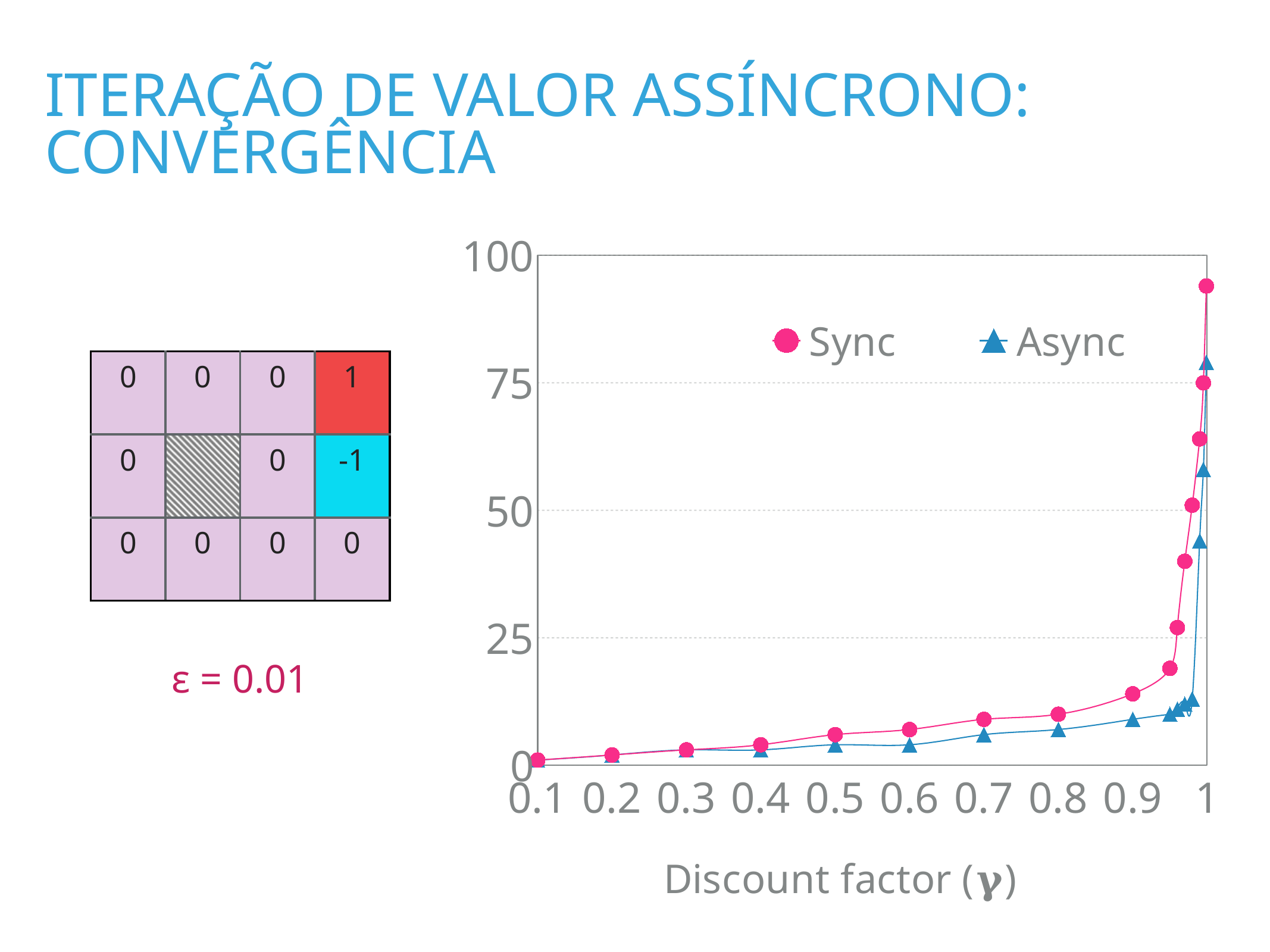
What are the two series named in the chart's legend? Sync and Async Is the Sync value at a discount factor of 0.5 greater or less than 25? less Do the Sync values rise or fall as the discount factor increases from 0.1 to 1? rise How many series does the chart's legend list? 2 What is the label of the chart's x axis? Discount factor (γ) What kind of chart is shown on the slide? line chart At a discount factor of 0.9, which series has the higher value, Sync or Async? Sync Is the Sync value at a discount factor of 0.9 greater or less than 25? less Is the Async value at a discount factor of 0.9 greater or less than 25? less At a discount factor of 1, which series has the higher value, Sync or Async? Sync